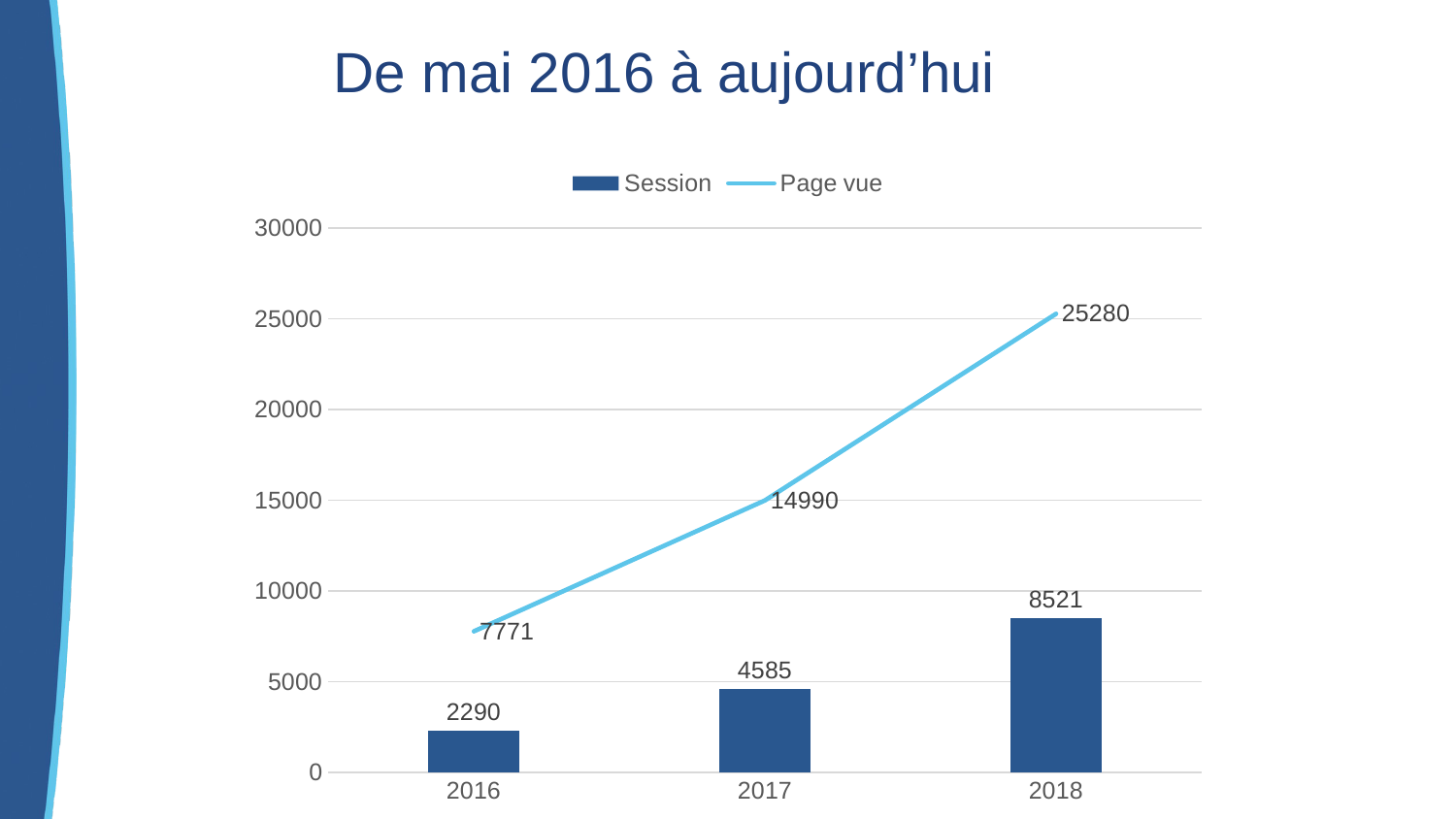
What is the Page vue value for 2018? 25280 Do the Page vue values rise or fall from 2016 to 2018? rise How many series does the legend list? 2 Which is larger, the Session value for 2017 or the Session value for 2016? 2017 What is the title of the slide? De mai 2016 à aujourd’hui What is the difference between the Session values for 2018 and 2016? 6231 What is the Session value for 2017? 4585 How many years are shown on the x axis? 3 What is the difference between the Page vue values for 2018 and 2017? 10290 Which year has the highest Session value? 2018 What is the Page vue value for 2016? 7771 Which year has the lowest Page vue value? 2016